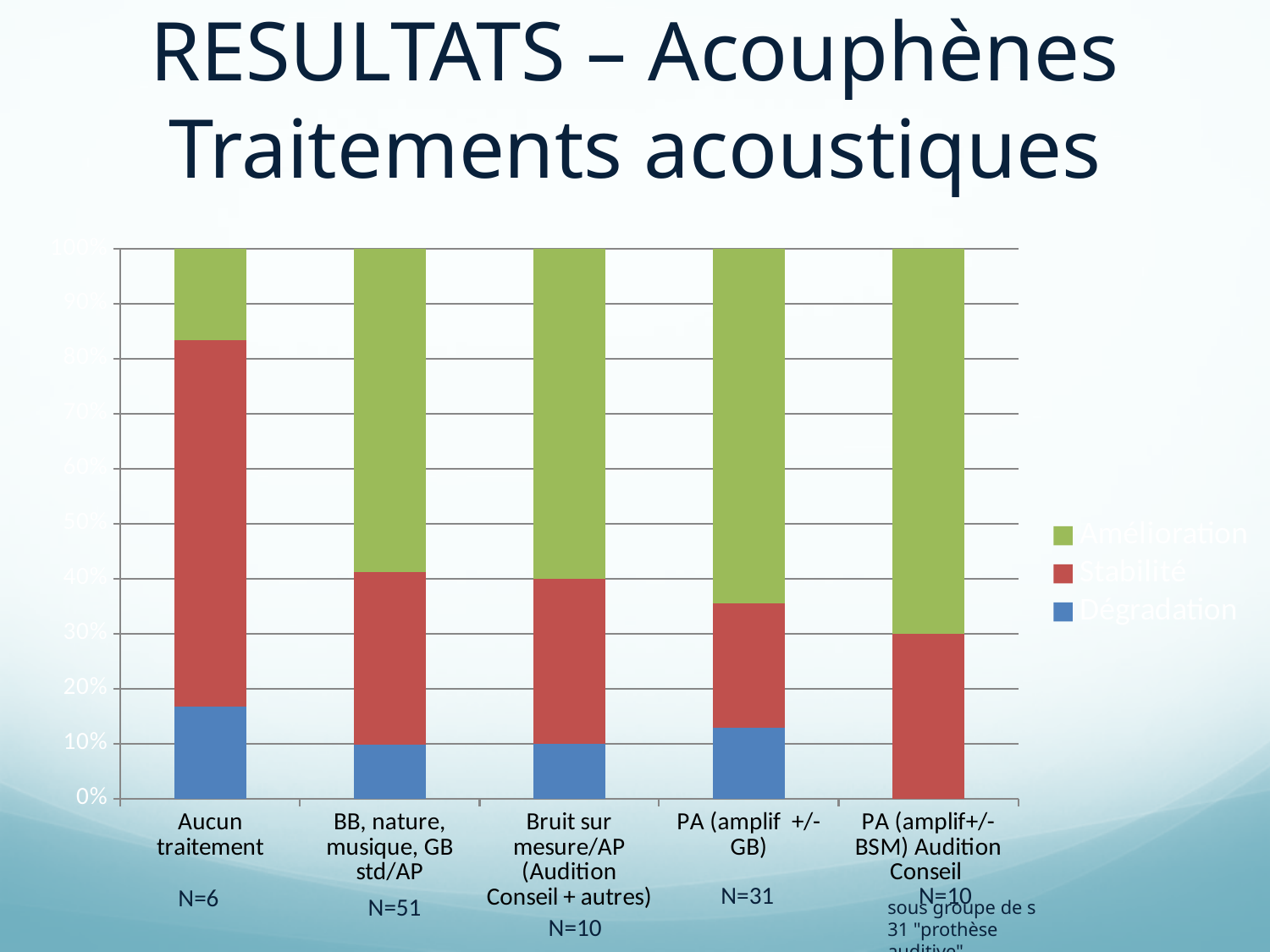
Which category shows no Dégradation segment at all? PA (amplif+/- BSM) Audition Conseil Which category has the largest Stabilité share? Aucun traitement Which has the larger Amélioration share: Aucun traitement or Bruit sur mesure/AP (Audition Conseil + autres)? Bruit sur mesure/AP (Audition Conseil + autres) Is the Dégradation share for Bruit sur mesure/AP (Audition Conseil + autres) greater or less than 20%? less Is the Stabilité share for Aucun traitement greater or less than 60%? greater Is the Amélioration share for Aucun traitement greater or less than 20%? less What kind of chart is shown on the slide? Stacked bar chart How many series does the legend list? 3 Which category has the largest Amélioration share? PA (amplif+/- BSM) Audition Conseil Which colour represents Stabilité in the legend? Red How many treatment categories are shown along the x axis? 5 Which category has the smallest Amélioration share? Aucun traitement